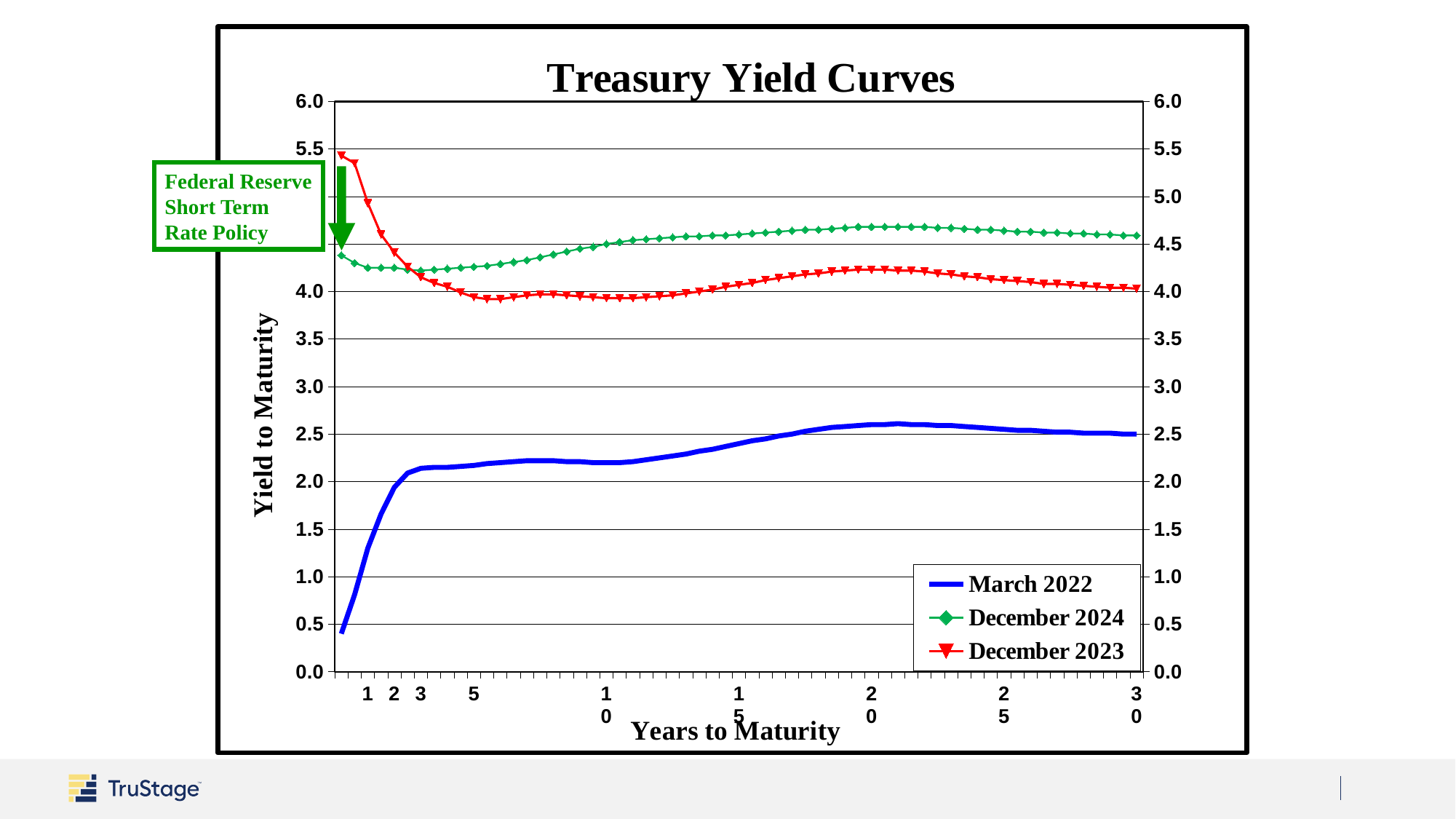
Does the March 2022 yield rise or fall between 1 and 5 years to maturity? rise Is the March 2022 yield at 20 years to maturity greater or less than 2.0? greater At 30 years to maturity, which series is higher: December 2024 or December 2023? December 2024 Which series has the lowest yields across all maturities? March 2022 How many series does the legend list? 3 What kind of chart is shown on the slide? Line chart Does the December 2023 yield rise or fall between 1 and 5 years to maturity? fall What is the title of the chart? Treasury Yield Curves At 1 year to maturity, which series is higher: December 2023 or December 2024? December 2023 What is the label of the x axis? Years to Maturity Is the December 2023 yield at 5 years to maturity greater or less than 4.5? less Is the December 2023 yield at the shortest maturity greater or less than 5.0? greater